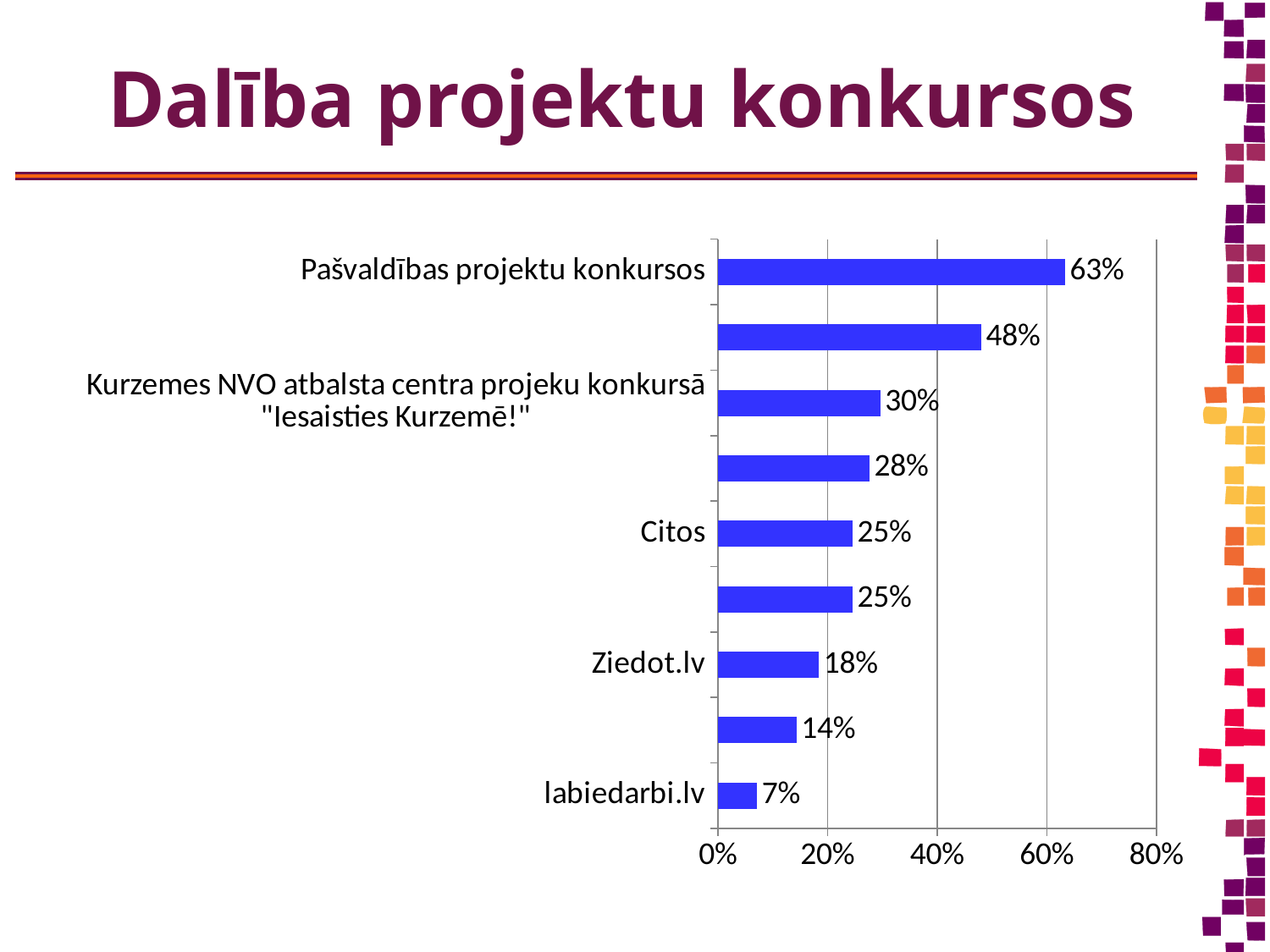
What is the value for Citos? 25% What is the value for labiedarbi.lv? 7% Is the value for Pašvaldības projektu konkursos greater or less than 60%? greater What is the value for Kurzemes NVO atbalsta centra projeku konkursā "Iesaisties Kurzemē!"? 30% What is the difference between the values for Pašvaldības projektu konkursos and Ziedot.lv? 45% How many bars are plotted in the chart? 9 What is the value for Ziedot.lv? 18% Which is larger, the value for Citos or the value for Ziedot.lv? Citos Which category has the lowest value? labiedarbi.lv Which category has the highest value? Pašvaldības projektu konkursos What is the value for Pašvaldības projektu konkursos? 63% What kind of chart is shown on the slide? Bar chart